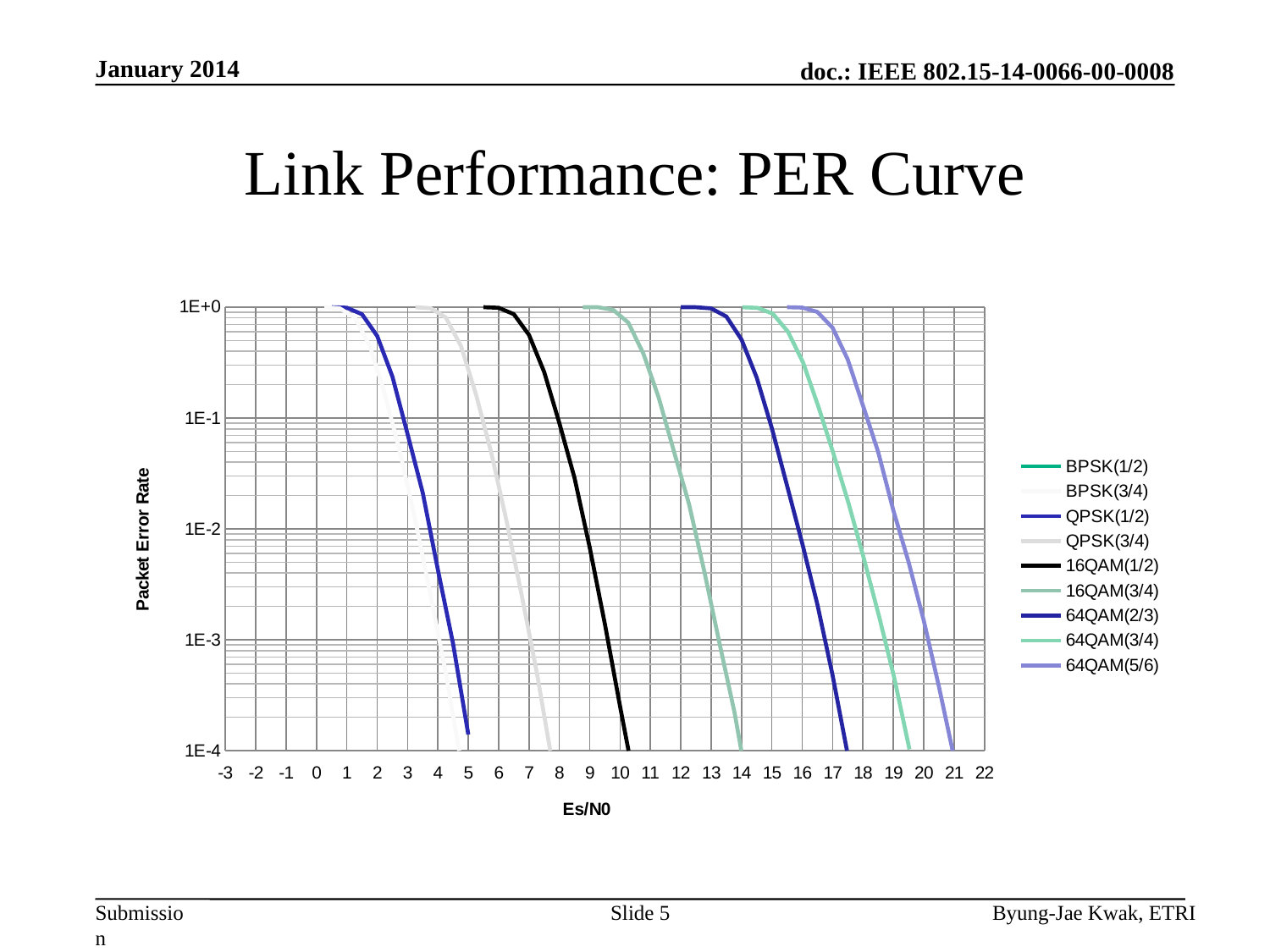
At Es/N0 = 9, which series has the higher Packet Error Rate, 16QAM(1/2) or 16QAM(3/4)? 16QAM(3/4) What is the title of the chart? Link Performance: PER Curve At Es/N0 = 10, is the Packet Error Rate for 16QAM(1/2) greater or less than 1E-3? less Which series reaches a Packet Error Rate of 1E-4 at the highest Es/N0? 64QAM(5/6) At Es/N0 = 21, is the Packet Error Rate for 64QAM(5/6) greater or less than 1E-3? less How many series does the legend list? 9 As Es/N0 increases, does the Packet Error Rate for each curve rise or fall? Fall At Es/N0 = 1, is the Packet Error Rate for QPSK(1/2) greater or less than 1E-1? greater What is the label of the x axis? Es/N0 What kind of chart is shown on the slide? Line chart